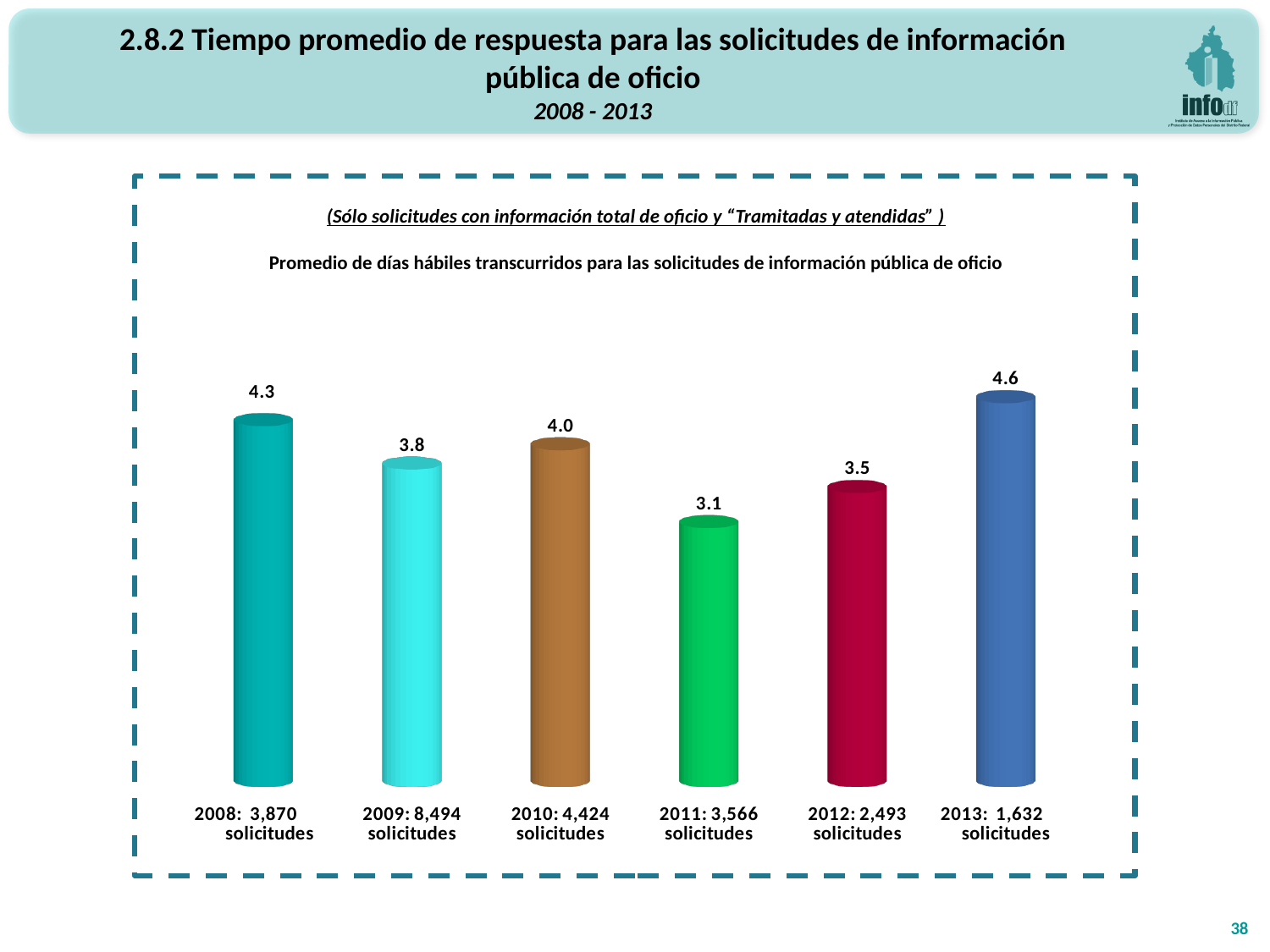
Which year has the highest average response time? 2013 What is the average number of business days for 2008? 4.3 What is the value shown for 2013? 4.6 What is the difference between the values for 2008 and 2009? 0.5 How many years are shown in the chart? 6 What kind of chart is shown on the slide? bar chart How many solicitudes are indicated in the axis label for 2009? 8,494 What is the value shown for 2011? 3.1 Which is larger, the value for 2010 or the value for 2012? 2010 What is the difference between the values for 2013 and 2011? 1.5 Which year has the lowest average response time? 2011 Does the value rise or fall from 2012 to 2013? rise